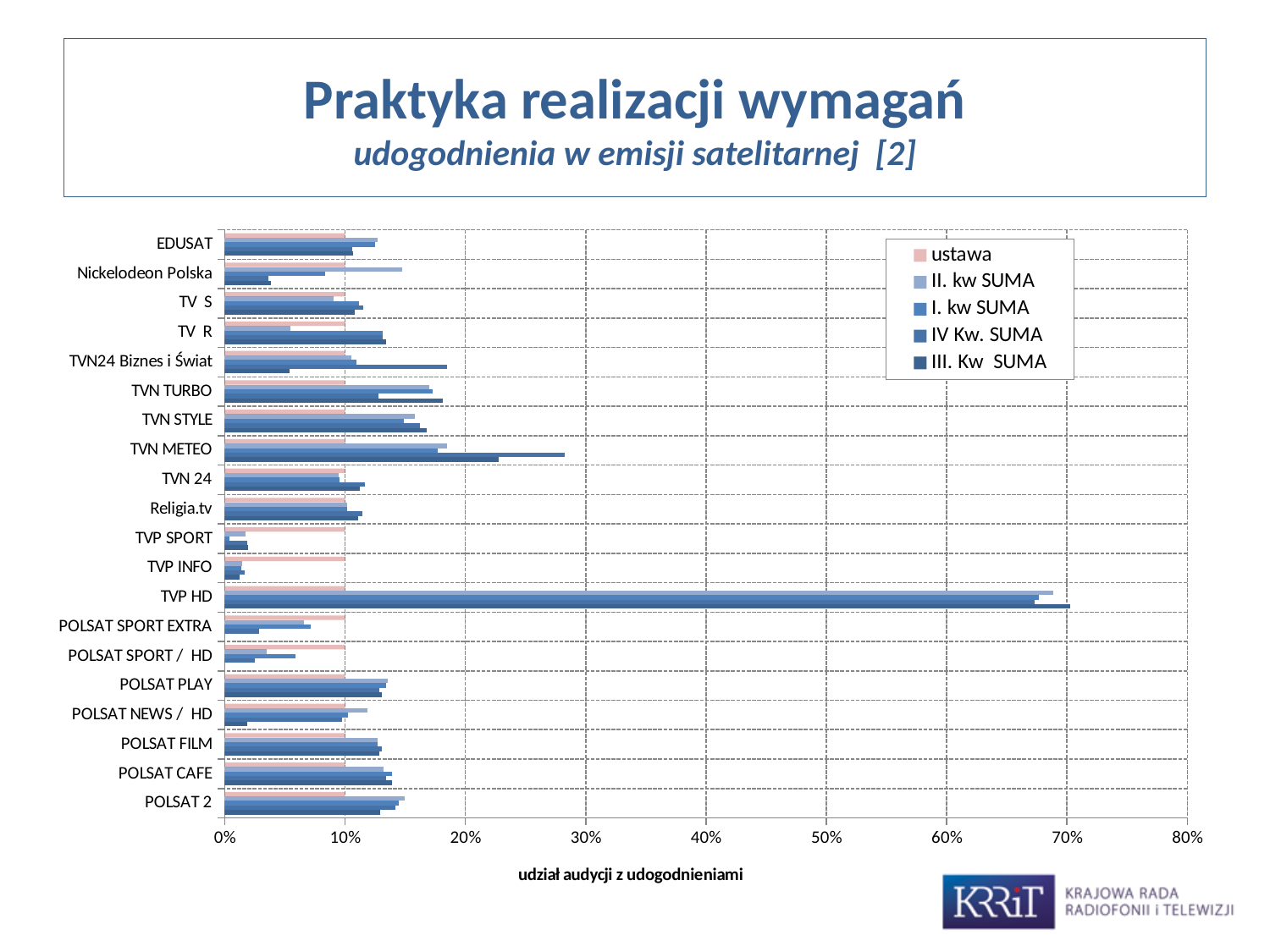
What is the first entry listed in the legend? ustawa How many channels (categories) are plotted on the chart? 20 Which channel has the larger III. Kw SUMA value, TVN METEO or TVN 24? TVN METEO What is the 'ustawa' value shown for EDUSAT? 10% What kind of chart is shown on the slide? bar chart Is the III. Kw SUMA value for TVN METEO greater or less than 20%? greater Which channel has the larger III. Kw SUMA value, TVP HD or POLSAT 2? TVP HD What is the label of the horizontal axis? udział audycji z udogodnieniami Is the I. kw SUMA value for TVP INFO greater or less than 10%? less How many series does the legend list? 5 Which channel has the highest values on the chart? TVP HD Is the III. Kw SUMA value for TVP HD greater or less than 60%? greater